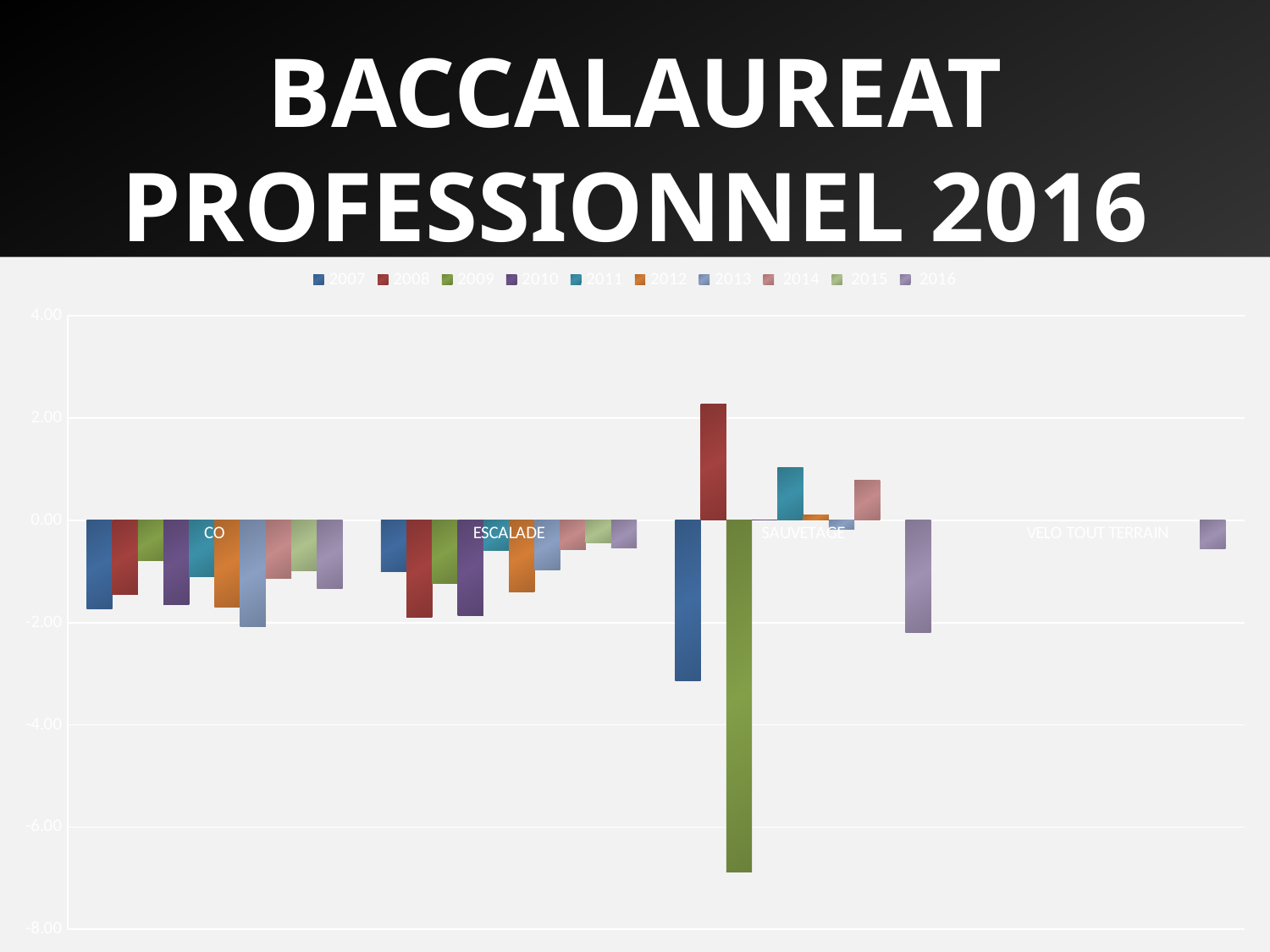
How many series does the legend list? 10 What kind of chart is shown on the slide? bar chart Which series has the lowest bar in the SAUVETAGE category? 2009 Is the value for 2008 in SAUVETAGE greater or less than 2.00? greater Is the value for 2007 in CO greater or less than -2.00? greater How many categories are shown on the x axis? 4 Which is larger, the value for 2008 or the value for 2011 in SAUVETAGE? 2008 Which series has the highest bar in the SAUVETAGE category? 2008 Is the value for 2007 in SAUVETAGE greater or less than -2.00? less What is the first year listed in the legend? 2007 Which category has the lowest bar on the chart? SAUVETAGE